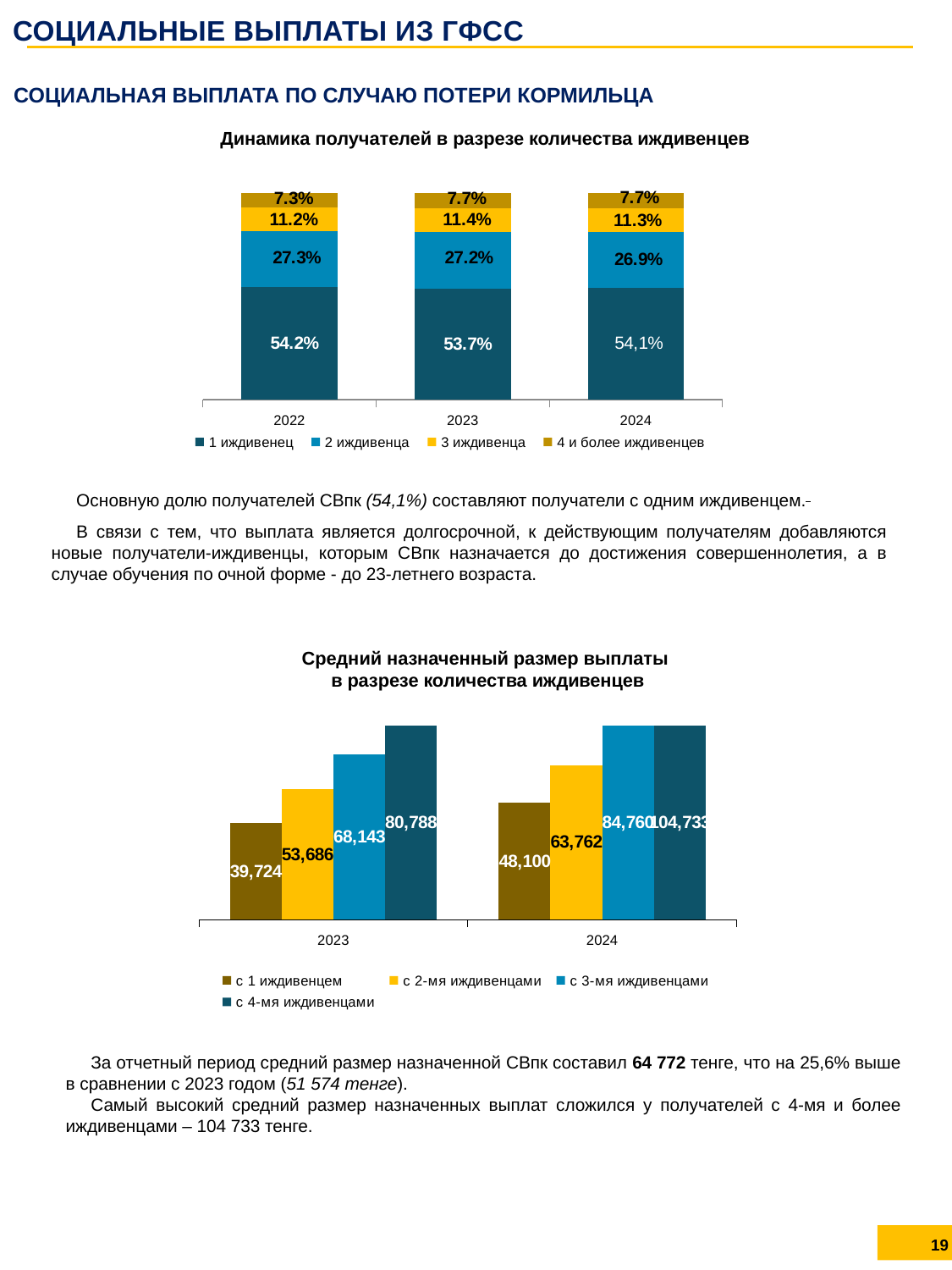
In the chart 'Средний назначенный размер выплаты в разрезе количества иждивенцев', what is the difference between the 'с 3-мя иждивенцами' values for 2024 and 2023? 16,617 In the chart 'Динамика получателей в разрезе количества иждивенцев', what is the value for '1 иждивенец' in 2022? 54.2% In the chart 'Средний назначенный размер выплаты в разрезе количества иждивенцев', what is the value for 'с 4-мя иждивенцами' in 2024? 104,733 In the chart 'Средний назначенный размер выплаты в разрезе количества иждивенцев', what is the value for 'с 1 иждивенцем' in 2023? 39,724 In the chart 'Динамика получателей в разрезе количества иждивенцев', what is the value for '2 иждивенца' in 2024? 26.9% In the chart 'Средний назначенный размер выплаты в разрезе количества иждивенцев', how many year categories are shown on the x axis? 2 In the chart 'Динамика получателей в разрезе количества иждивенцев', what is the value for '4 и более иждивенцев' in 2023? 7.7% In the chart 'Динамика получателей в разрезе количества иждивенцев', which series has the largest share in 2023? 1 иждивенец In the chart 'Средний назначенный размер выплаты в разрезе количества иждивенцев', which series has the lowest value in 2024? с 1 иждивенцем In the chart 'Динамика получателей в разрезе количества иждивенцев', what is the difference between the '3 иждивенца' values for 2023 and 2022? 0.2% What kind of chart is 'Динамика получателей в разрезе количества иждивенцев'? Stacked bar chart In the chart 'Динамика получателей в разрезе количества иждивенцев', how many series does the legend list? 4